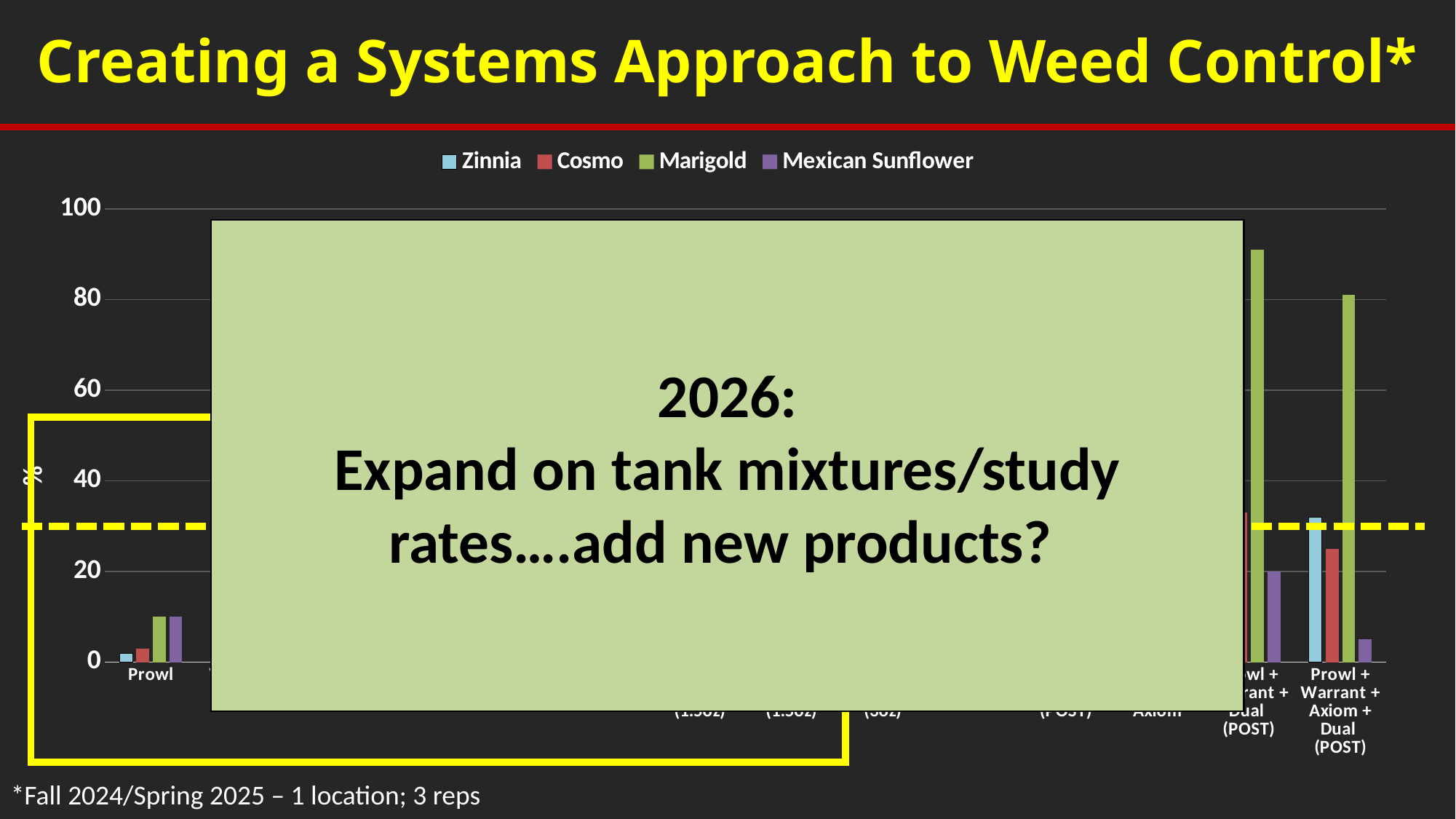
Is the Zinnia value for Prowl + Warrant + Axiom + Dual (POST) greater or less than 20? greater Is the Marigold value for Prowl + Warrant + Axiom + Dual (POST) greater or less than 60? greater What is the highest value shown on the chart's vertical axis? 100 Which series has the highest value for Prowl + Warrant + Axiom + Dual (POST)? Marigold Is the Zinnia value for Prowl greater or less than 20? less How many series does the chart legend list? 4 Which series has the lowest value for Prowl + Warrant + Axiom + Dual (POST)? Mexican Sunflower What kind of chart is shown on the slide? bar chart Which series are listed in the chart legend? Zinnia, Cosmo, Marigold, Mexican Sunflower For Prowl + Warrant + Axiom + Dual (POST), which is larger: the Marigold value or the Mexican Sunflower value? Marigold